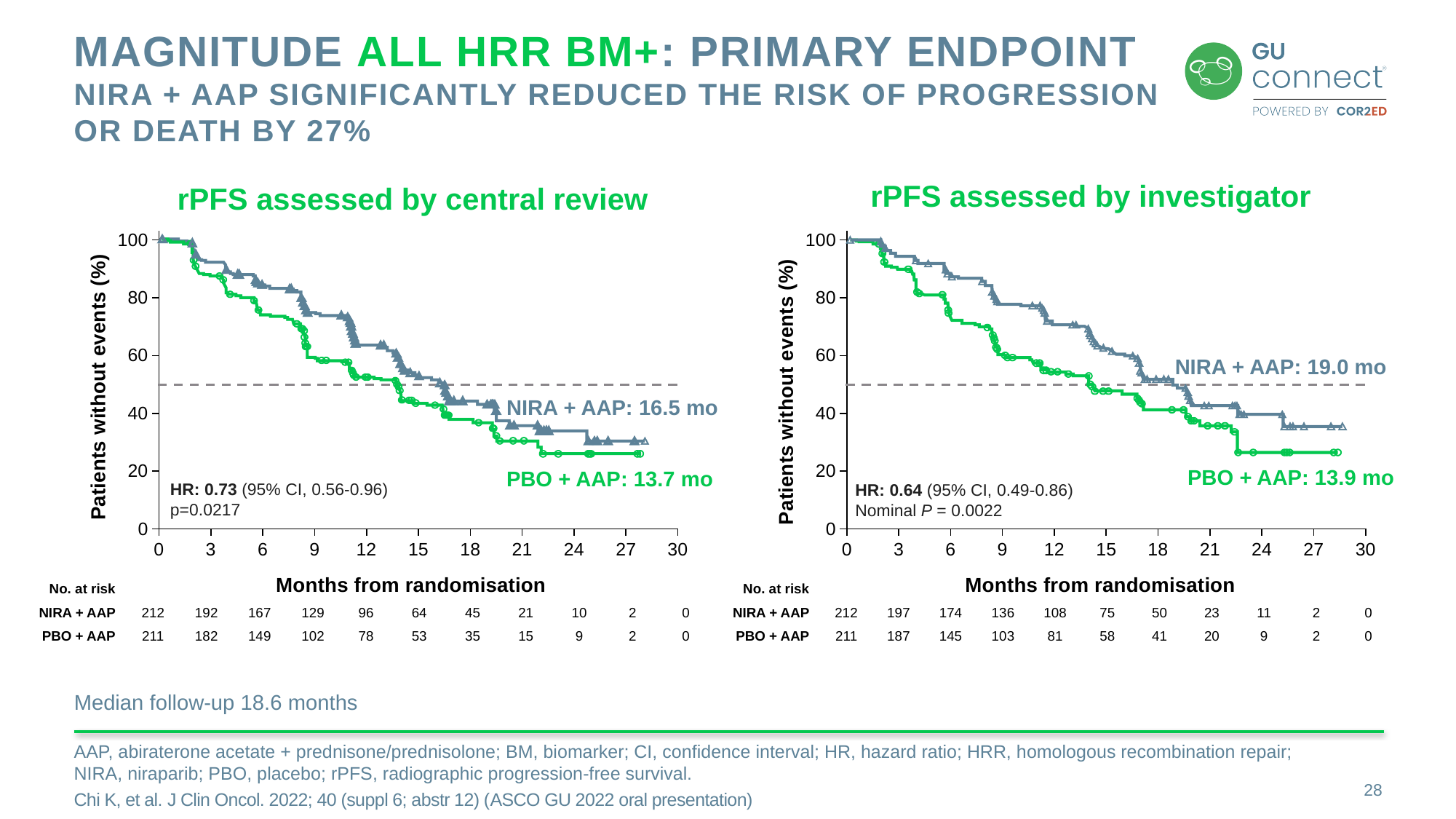
In the 'rPFS assessed by central review' chart, do the curves rise or fall as months from randomisation increase? fall In the 'rPFS assessed by central review' chart, which arm has the longer median rPFS, NIRA + AAP or PBO + AAP? NIRA + AAP In the 'rPFS assessed by central review' chart, what is the hazard ratio shown? 0.73 In the 'rPFS assessed by central review' chart, how many NIRA + AAP patients were at risk at 12 months? 96 In the 'rPFS assessed by central review' chart, what is the median rPFS for NIRA + AAP? 16.5 mo In the 'rPFS assessed by investigator' chart, what is the median rPFS for NIRA + AAP? 19.0 mo In the 'rPFS assessed by investigator' chart, what is the difference in median rPFS between NIRA + AAP and PBO + AAP? 5.1 mo In the 'rPFS assessed by investigator' chart, what is the hazard ratio shown? 0.64 In the 'rPFS assessed by investigator' chart, what is the median rPFS for PBO + AAP? 13.9 mo In the 'rPFS assessed by central review' chart, is the NIRA + AAP value at 27 months greater or less than 40? less In the 'rPFS assessed by central review' chart, what is the median rPFS for PBO + AAP? 13.7 mo In the 'rPFS assessed by investigator' chart, how many PBO + AAP patients were at risk at 9 months? 103